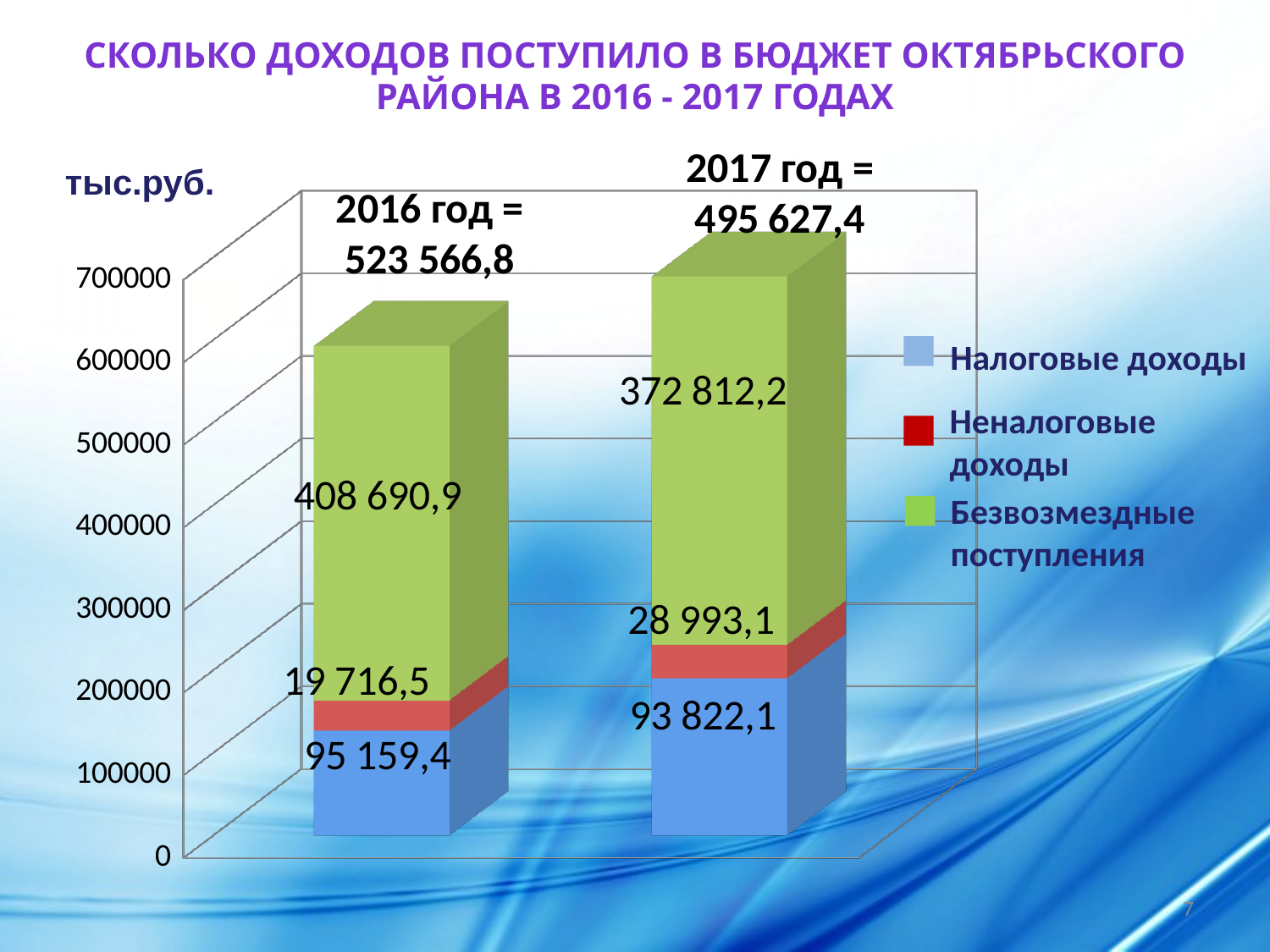
What is the value of Неналоговые доходы for 2017? 28 993,1 What is the difference between Безвозмездные поступления in 2016 and in 2017? 35 878,7 What unit of measurement is indicated for the chart values? тыс.руб. How many series does the legend list? 3 How many bars (years) are plotted in the chart? 2 What type of chart is shown on the slide? Stacked bar chart What is the value of Безвозмездные поступления for 2016? 408 690,9 Which series is the smallest component of the 2016 bar? Неналоговые доходы What is the value of Налоговые доходы for 2016? 95 159,4 Which series is the largest component of the 2017 bar? Безвозмездные поступления Which year has the higher total budget income, 2016 or 2017? 2016 What is the total of the stacked bar for 2017? 495 627,4